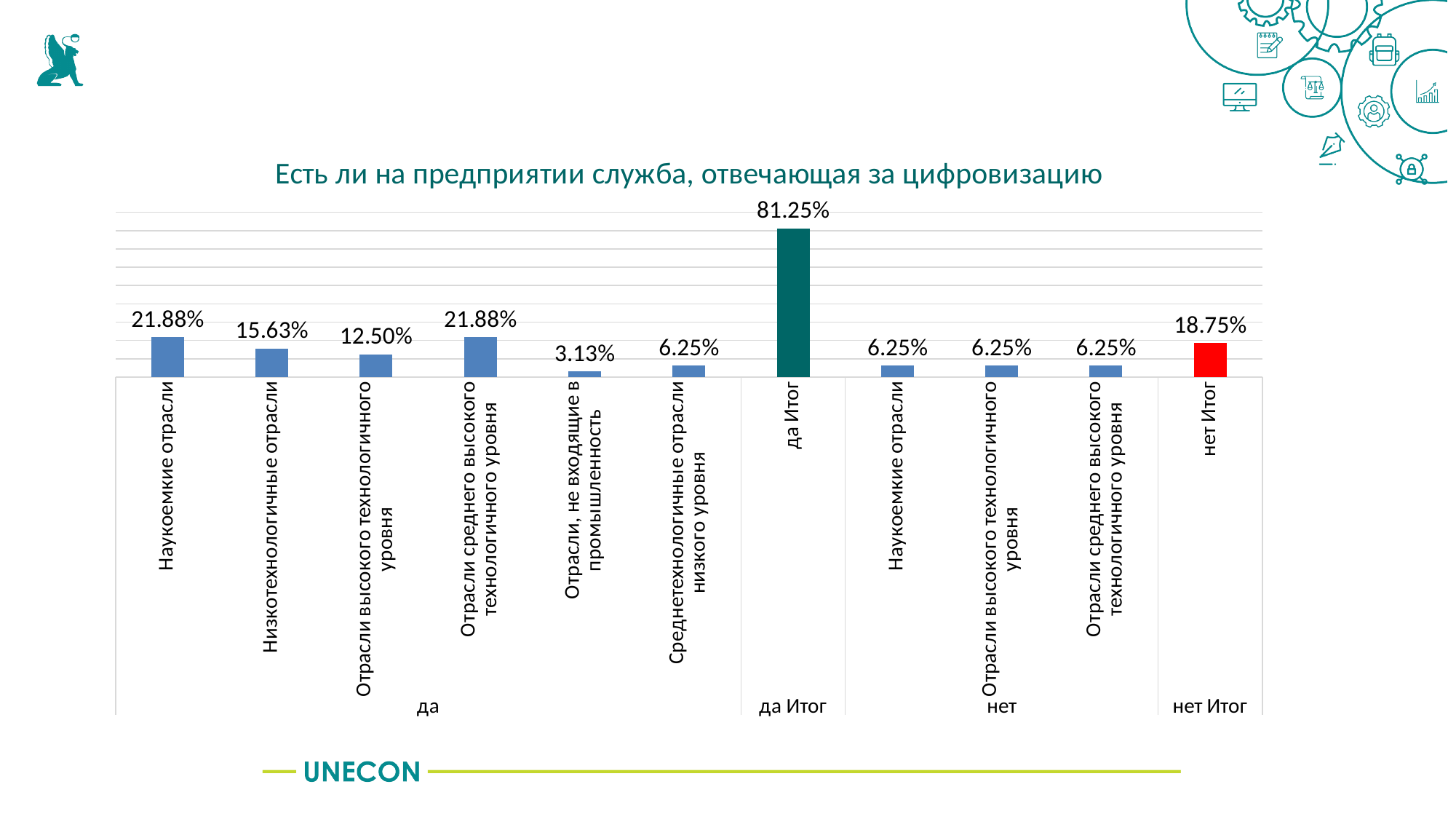
In the 'нет' group, what is the value for 'Наукоемкие отрасли'? 6.25% In the 'да' group, which is larger: 'Наукоемкие отрасли' or 'Отрасли высокого технологичного уровня'? Наукоемкие отрасли Which bar has the highest value in the chart? да Итог What is the value of the 'да Итог' bar? 81.25% What is the title of the chart? Есть ли на предприятии служба, отвечающая за цифровизацию Which bar has the lowest value in the chart? Отрасли, не входящие в промышленность (да) How many bars are plotted in the chart? 11 What type of chart is shown on the slide? bar chart In the 'да' group, what is the value for 'Низкотехнологичные отрасли'? 15.63% What is the difference between the 'да Итог' and 'нет Итог' values? 62.50% What is the value of the 'нет Итог' bar? 18.75% In the 'да' group, what is the value for 'Отрасли, не входящие в промышленность'? 3.13%